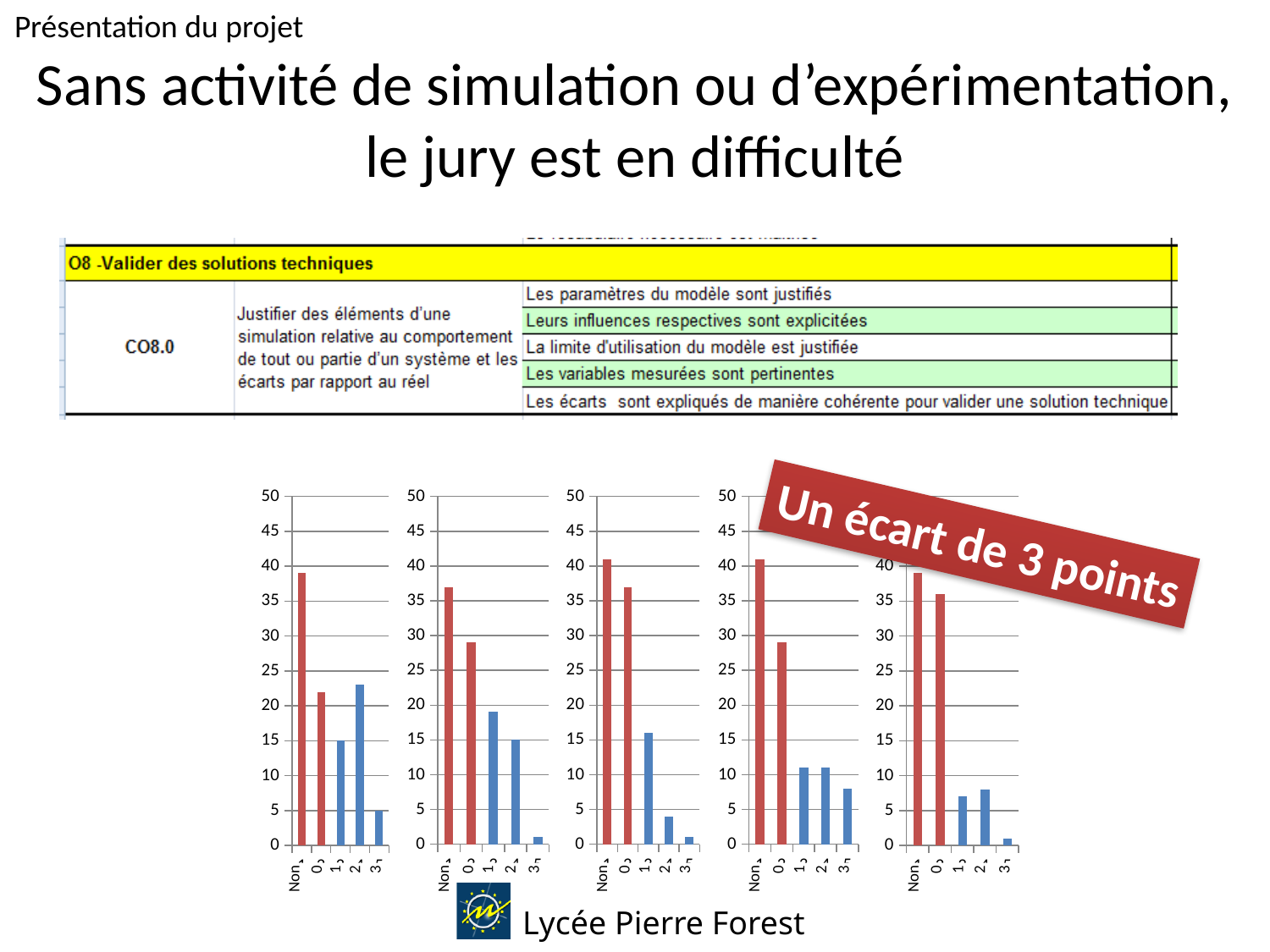
In the leftmost chart, which is larger, the value for 1 or the value for 2? 2 In the third chart from the left, is the value for 2 greater or less than 10? less In the second chart from the left, is the value for 0 greater or less than 25? greater In the leftmost chart, which category has the highest value? Non In the third chart from the left, which is larger, the value for 1 or the value for 2? 1 In the fourth chart from the left, which category has the lowest value? 3 In the leftmost chart, is the value for Non greater or less than 35? greater In the leftmost chart, which category has the lowest value? 3 How many categories are shown on the x axis of the leftmost chart? 5 How many bar charts are shown on the slide? 5 What kind of chart is the leftmost chart on the slide? bar chart